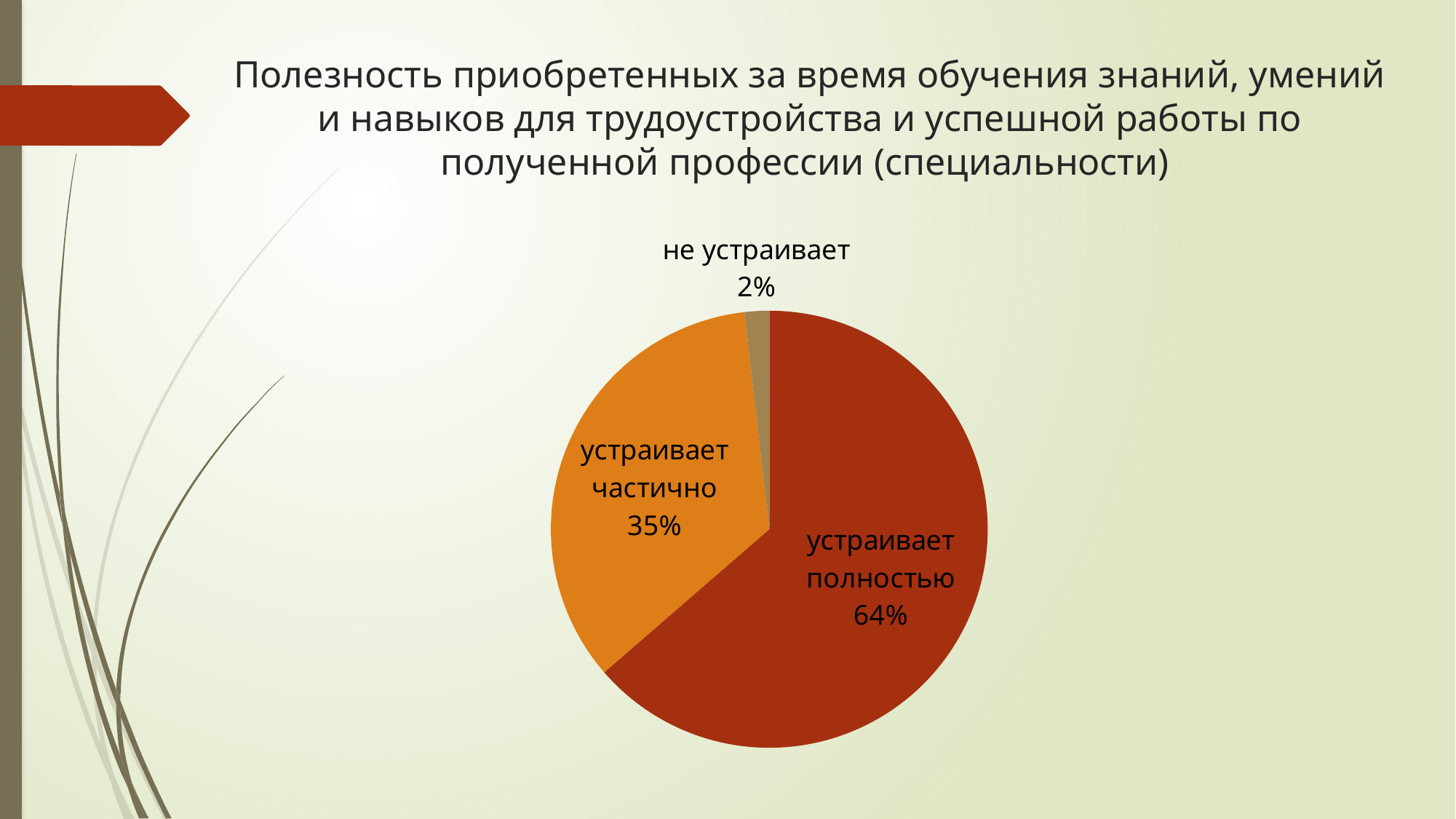
What share of the pie does "устраивает полностью" take? 64% What is the difference in percentage points between "устраивает полностью" and "устраивает частично"? 29 Which is larger: the slice for "устраивает частично" or the slice for "не устраивает"? устраивает частично What is the difference in percentage points between "устраивает частично" and "не устраивает"? 33 What share of the pie does "не устраивает" take? 2% How many slices does the pie chart have? 3 Which category has the largest slice of the pie? устраивает полностью What share of the pie does "устраивает частично" take? 35% Which category has the smallest slice of the pie? не устраивает What colour is the slice for "устраивает частично"? orange What kind of chart is shown on the slide? pie chart Is the share for "устраивает полностью" greater or less than 50%? greater